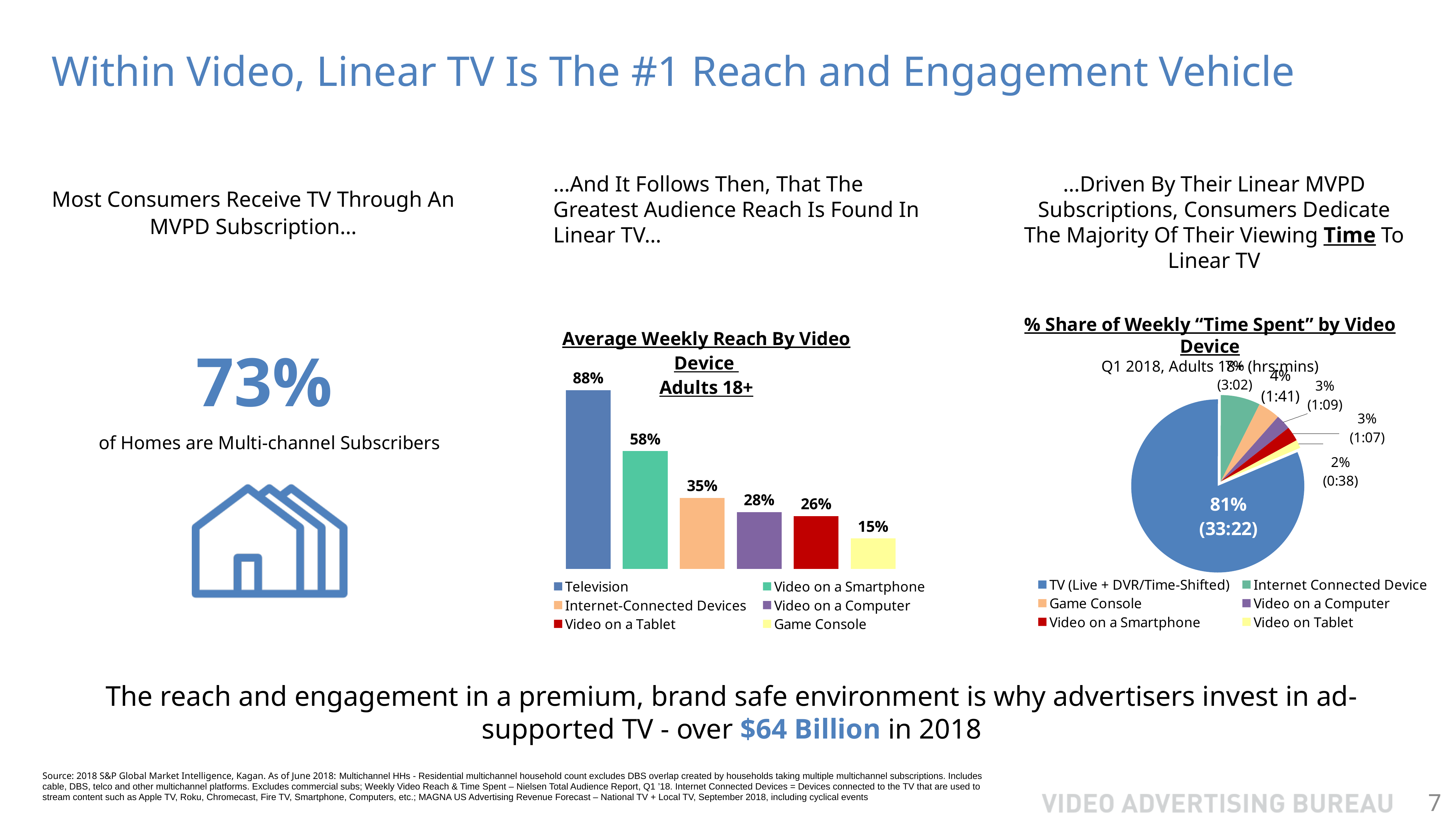
In the 'Average Weekly Reach By Video Device' bar chart, what is the difference between Television and Video on a Smartphone? 30% How many bars are in the 'Average Weekly Reach By Video Device' chart? 6 In the 'Average Weekly Reach By Video Device' bar chart, which device has the lowest weekly reach? Game Console In the 'Average Weekly Reach By Video Device' bar chart, which device has the highest weekly reach? Television In the '% Share of Weekly Time Spent by Video Device' pie chart, what is the time shown for Game Console? 1:41 In the 'Average Weekly Reach By Video Device' bar chart, what is the value for Video on a Smartphone? 58% In the '% Share of Weekly Time Spent by Video Device' pie chart, what share does TV (Live + DVR/Time-Shifted) have? 81% What type of chart is 'Average Weekly Reach By Video Device'? Bar chart In the 'Average Weekly Reach By Video Device' bar chart, what is the value for Television? 88% In the 'Average Weekly Reach By Video Device' bar chart, which is larger: Internet-Connected Devices or Video on a Computer? Internet-Connected Devices What type of chart is '% Share of Weekly Time Spent by Video Device'? Pie chart In the 'Average Weekly Reach By Video Device' bar chart, what is the value for Game Console? 15%